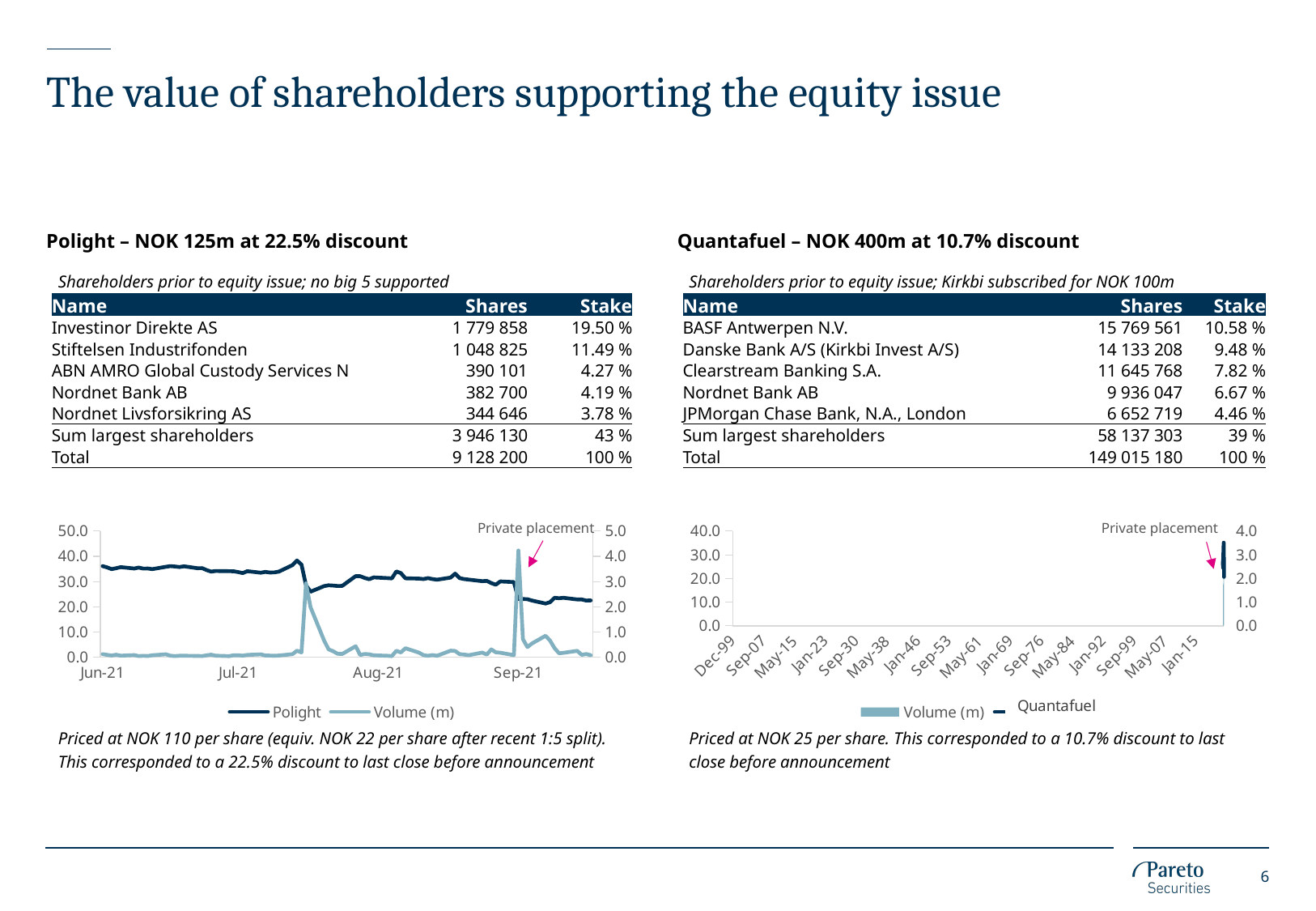
How many series does the legend of the Polight chart on the left list? 2 In the Polight chart on the left, is the Polight value at the end of the series (after Sep-21) greater or less than 30.0? less In the Polight chart on the left, is the peak of the Volume (m) series near Sep-21 greater or less than 3.0 on the right axis? greater In the Polight chart on the left, does the Polight line rise or fall from Jun-21 to Sep-21? fall In the Polight chart on the left, is the Polight value at Jun-21 greater or less than 30.0? greater In the Quantafuel chart on the right, how many date labels are shown on the x axis? 16 In the Quantafuel chart on the right, what event does the pink arrow annotation point to? Private placement In the Polight chart on the left, how many month labels are shown on the x axis? 4 How many series does the legend of the Quantafuel chart on the right list? 2 In the Quantafuel chart on the right, what is the highest value shown on the right y axis? 4.0 In the Polight chart on the left, what is the highest value shown on the left y axis? 50.0 What kind of chart is the Polight chart on the left of the slide? line chart